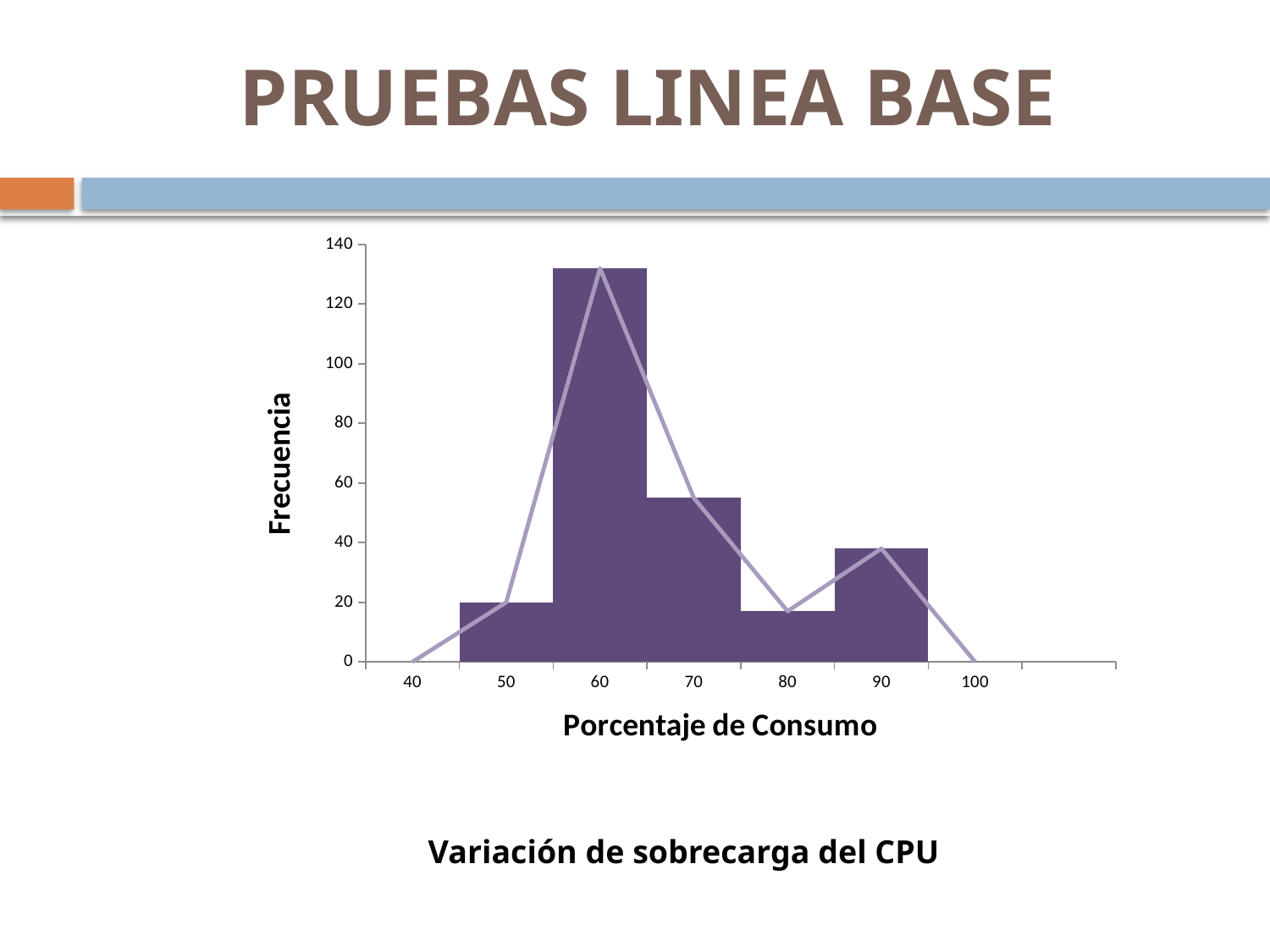
Which has a higher frequency, 70 or 90? 70 What is the title of the x axis? Porcentaje de Consumo Which of the bars shown has the lowest frequency? 80 What kind of chart is shown on the slide? bar chart with a line overlay Is the frequency for 60 greater or less than 120? greater Which consumption percentage has the highest frequency? 60 What is the frequency value of the line at 100? 0 How many bars are plotted in the chart? 5 Is the frequency for 70 greater or less than 60? less Which has a higher frequency, 50 or 90? 90